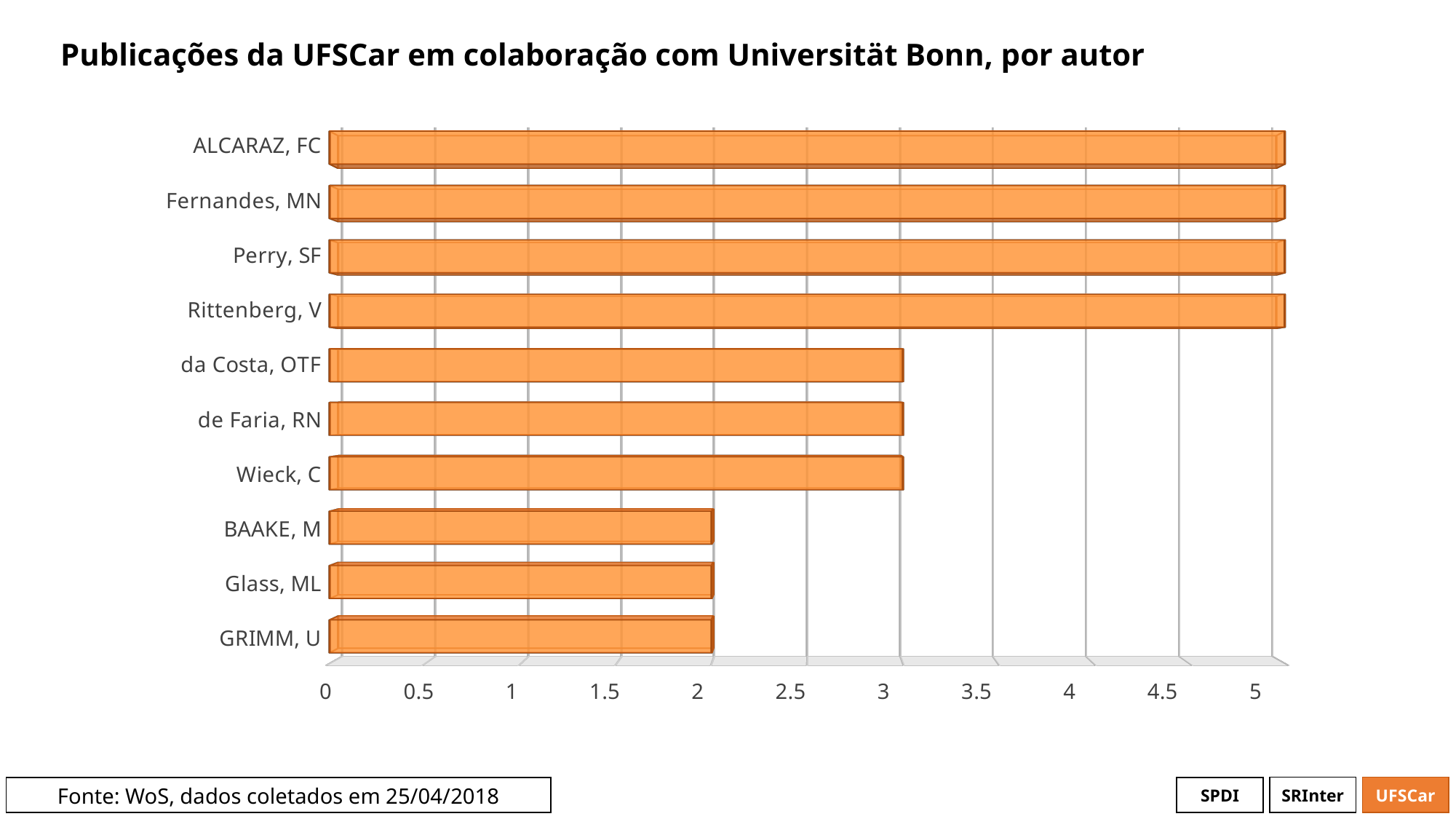
What is the value shown for da Costa, OTF? 3 What is the value shown for GRIMM, U? 2 What is the title of the chart? Publicações da UFSCar em colaboração com Universität Bonn, por autor Is the value for Glass, ML greater or less than 3? less Which has the larger value, BAAKE, M or de Faria, RN? de Faria, RN Which has the larger value, Perry, SF or Wieck, C? Perry, SF Is the value for Rittenberg, V greater or less than 4? greater How many authors are listed on the chart? 10 What colour are the bars in the chart? orange What kind of chart is shown on the slide? bar chart What is the difference between the values for Fernandes, MN and Wieck, C? 2 How many publications does the bar for ALCARAZ, FC show? 5